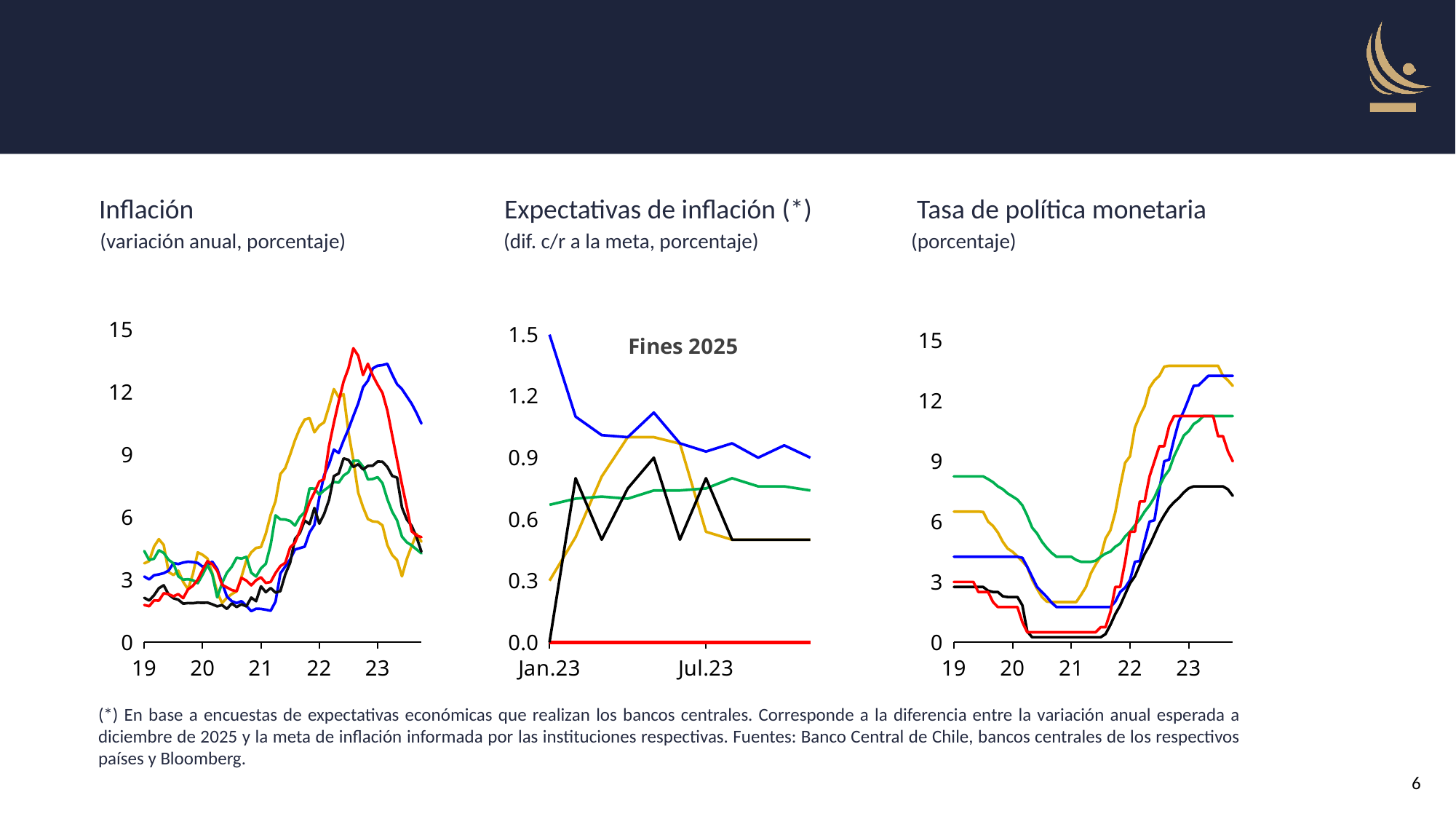
What kind of chart is the 'Inflación' chart? line chart On the 'Tasa de política monetaria' chart, is the peak of the yellow line greater or less than 12? greater On the 'Expectativas de inflación (*)' chart, what is the value of the red line at Jan.23? 0.0 How many lines are plotted on the 'Tasa de política monetaria' chart? 5 On the 'Inflación' chart, is the value of the blue line at the right end greater or less than 9? greater On the 'Tasa de política monetaria' chart, does the black line rise or fall between 21 and 23? rise What annotation text appears inside the 'Expectativas de inflación (*)' chart? Fines 2025 On the 'Tasa de política monetaria' chart, is the value of the black line at the right end greater or less than 9? less On the 'Expectativas de inflación (*)' chart, what is the value of the blue line at Jan.23? 1.5 On the 'Expectativas de inflación (*)' chart, which line is lowest across the whole period? the red line On the 'Expectativas de inflación (*)' chart, does the blue line rise or fall from Jan.23 to the right end? fall